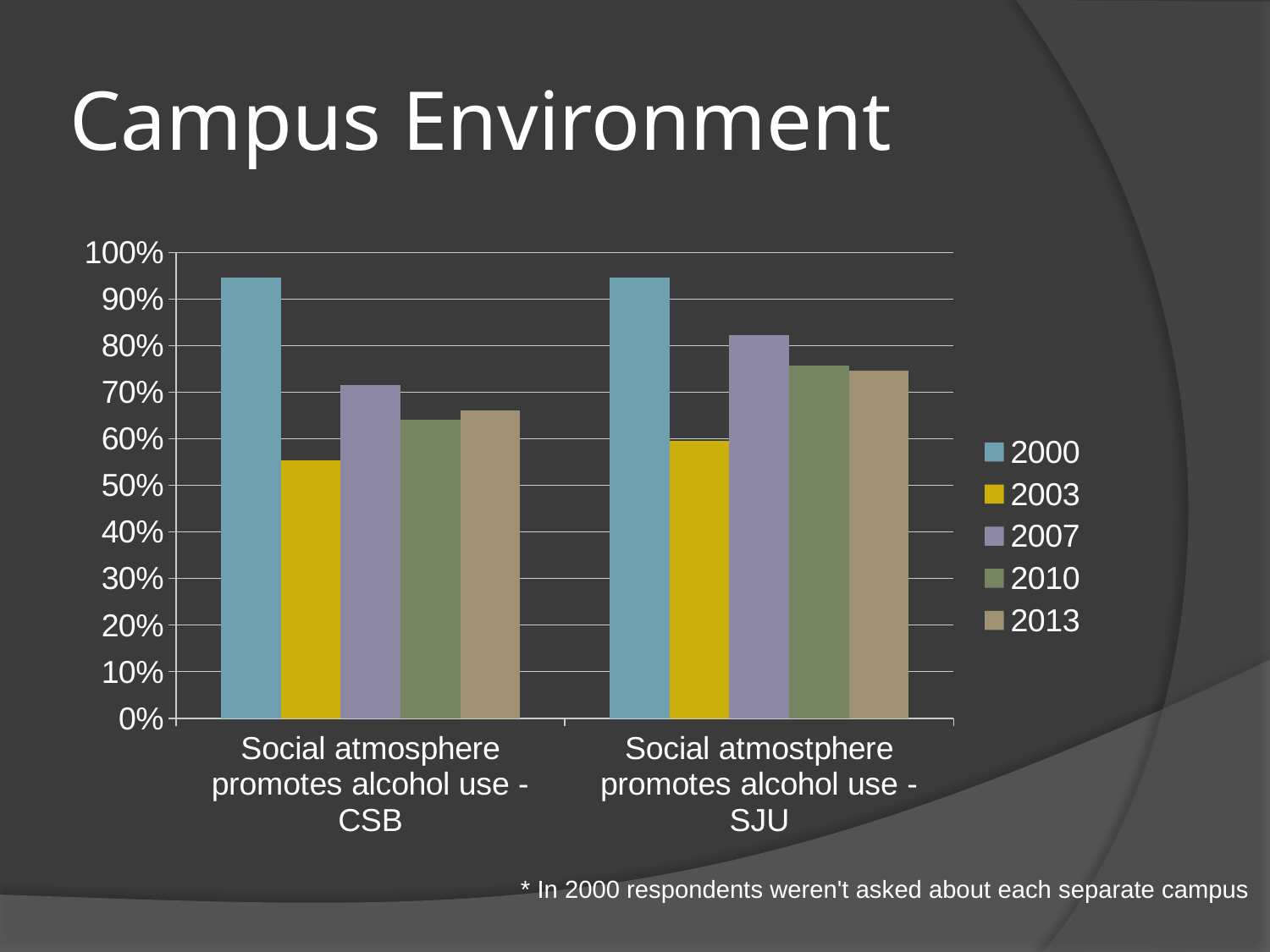
Which is larger, the 2007 value for CSB or the 2007 value for SJU? SJU For 'Social atmosphere promotes alcohol use - CSB', which year has the highest value? 2000 Which is larger, the 2010 value for CSB or the 2010 value for SJU? SJU Is the 2007 value for 'Social atmostphere promotes alcohol use - SJU' greater or less than 70%? greater Is the 2003 value for 'Social atmosphere promotes alcohol use - CSB' greater or less than 60%? less What kind of chart is shown on the slide? bar chart How many categories are shown on the x axis? 2 How many series does the legend list? 5 For 'Social atmostphere promotes alcohol use - SJU', which year has the lowest value? 2003 What is the title of the slide? Campus Environment For 'Social atmosphere promotes alcohol use - CSB', which year has the lowest value? 2003 Is the 2000 value for 'Social atmosphere promotes alcohol use - CSB' greater or less than 90%? greater